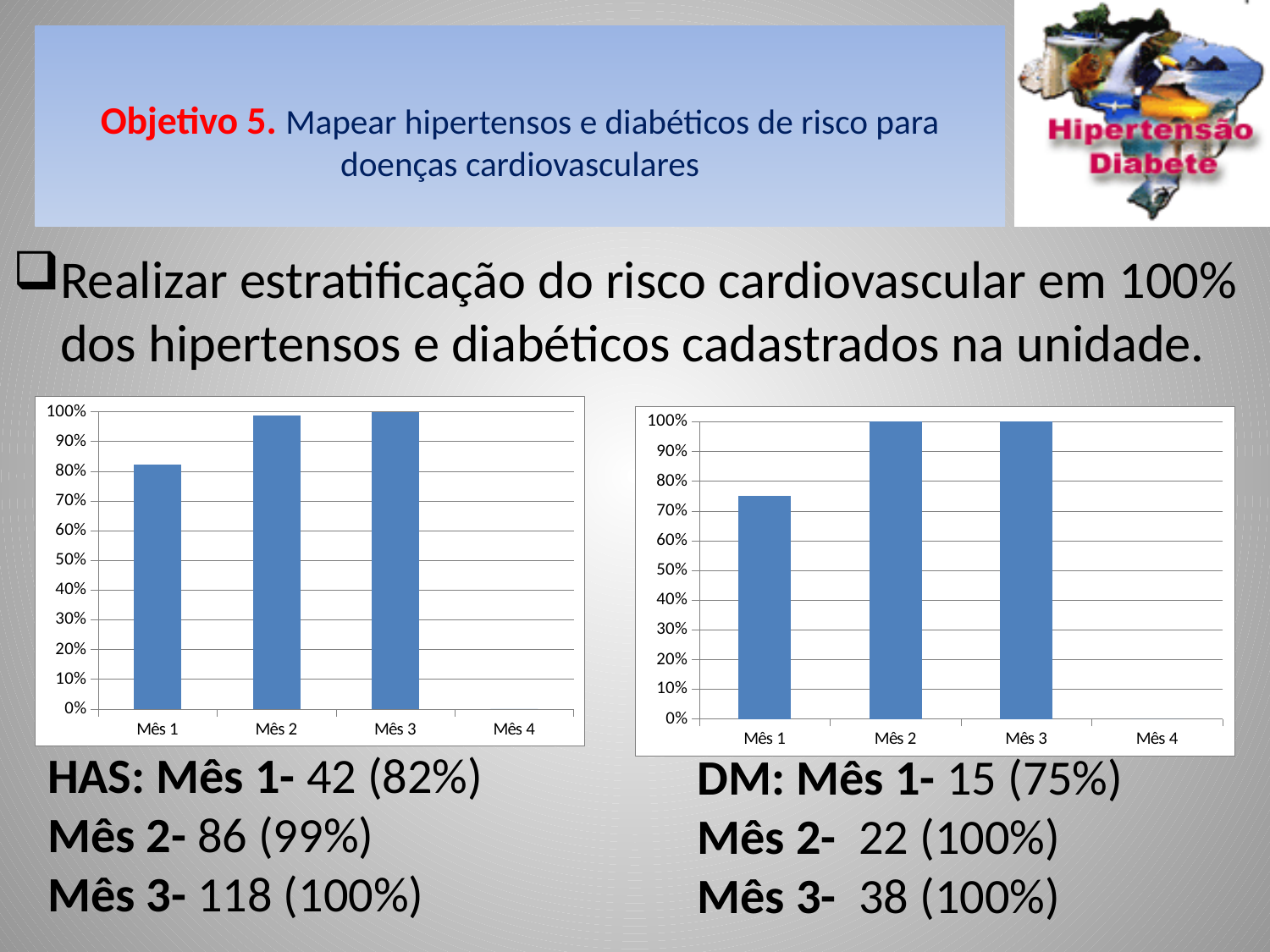
In the left chart, is the value for Mês 1 greater or less than 80%? greater In the right chart, which is larger, the value for Mês 1 or the value for Mês 3? Mês 3 In the left chart, what is the value for Mês 3? 100% In the right chart, what is the value for Mês 2? 100% What is the highest tick value shown on the y axis of the right chart? 100% In the right chart, is the value for Mês 1 greater or less than 80%? less In the left chart, which is larger, the value for Mês 1 or the value for Mês 2? Mês 2 How many month categories are shown on the x axis of the right chart? 4 In the left chart, do the values rise or fall from Mês 1 to Mês 3? rise What type of chart is the left chart on the slide? bar chart